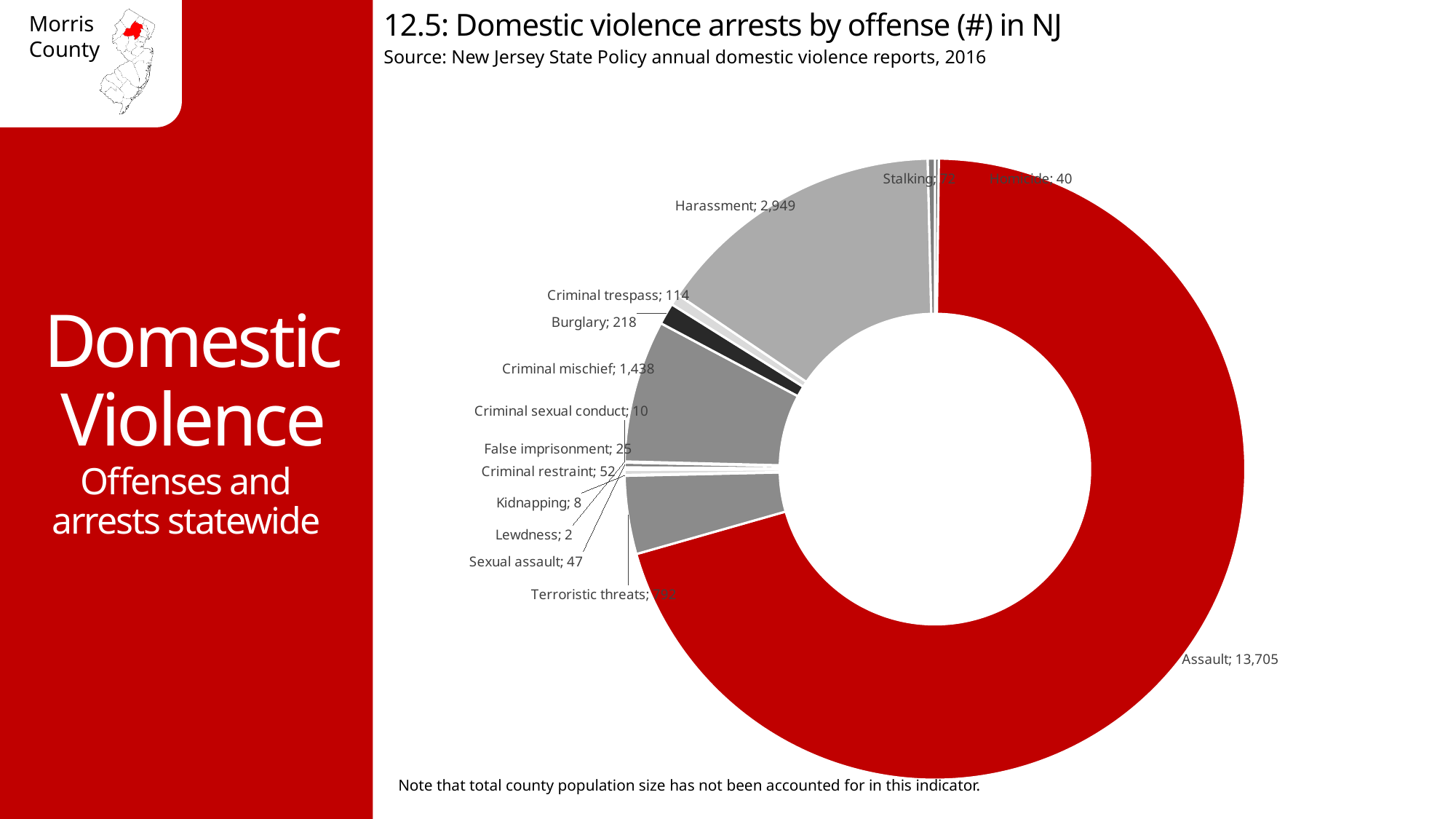
Which offense has the lowest number of arrests? Lewdness Which offense has the highest number of arrests? Assault How many arrests are shown for Harassment? 2,949 What kind of chart is shown on the slide? doughnut (pie) chart How many arrests are shown for Criminal mischief? 1,438 How many domestic violence arrests for Assault are shown? 13,705 How many offense categories are shown in the chart? 14 What is the difference between the arrests for Burglary and Criminal trespass? 104 What is the title of the chart? 12.5: Domestic violence arrests by offense (#) in NJ Which has more arrests, Criminal mischief or Harassment? Harassment What is the difference between the arrests for Criminal restraint and False imprisonment? 27 How many arrests are shown for Homicide? 40